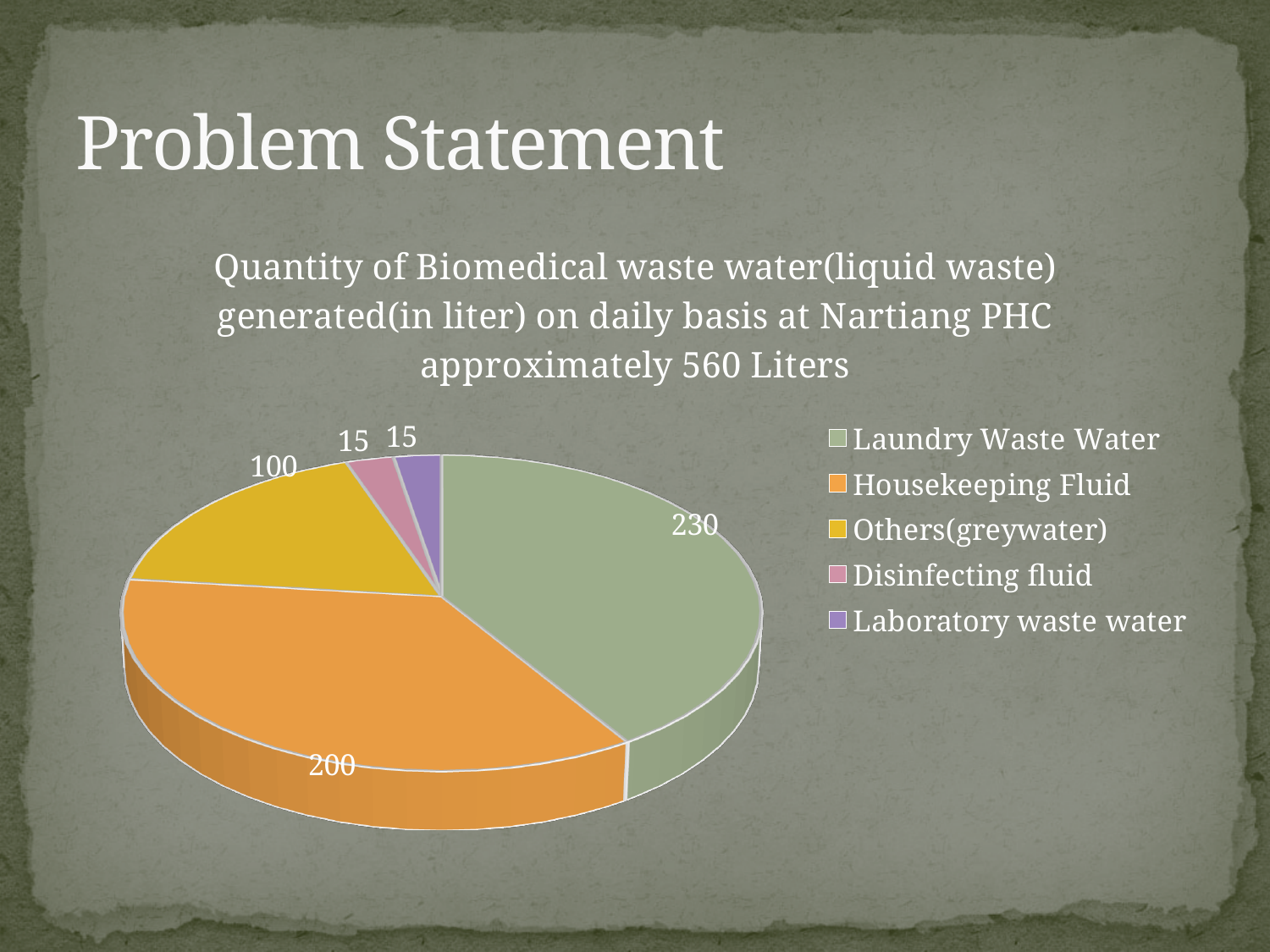
What is the value for Housekeeping Fluid? 200 Which is larger, the value for Others(greywater) or the value for Laboratory waste water? Others(greywater) What is the difference between the values for Laundry Waste Water and Housekeeping Fluid? 30 What is the value for Disinfecting fluid? 15 How many categories does the pie chart show? 5 What is the difference between the values for Housekeeping Fluid and Others(greywater)? 100 Which category has the largest slice of the pie? Laundry Waste Water What is the value for Others(greywater)? 100 What is the value for Laundry Waste Water? 230 Which category is shown in orange in the pie chart? Housekeeping Fluid What is the total of all the slices in the pie chart? 560 What type of chart is shown on the slide? pie chart